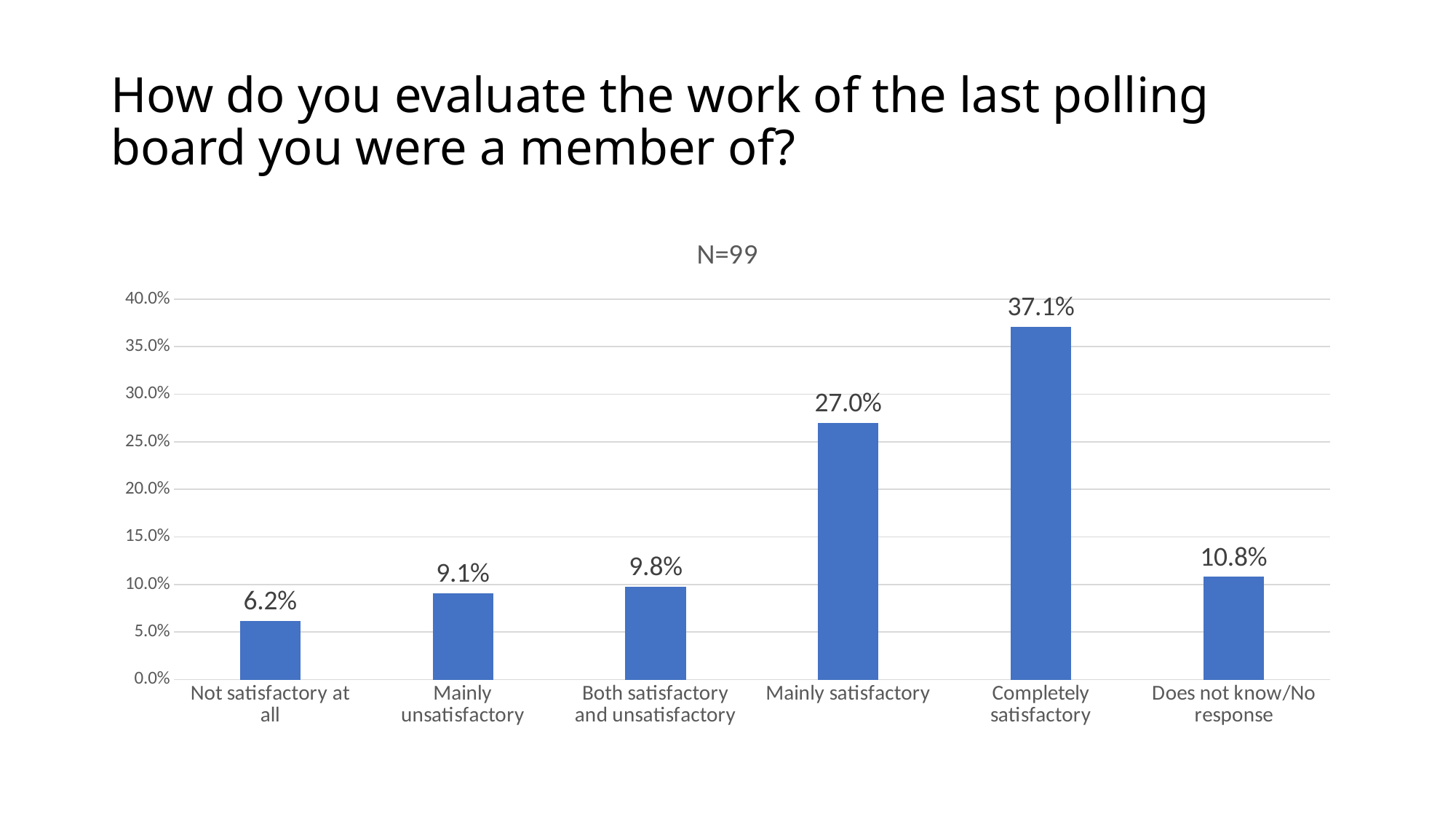
Which category has the highest value? Completely satisfactory Which category has the lowest value? Not satisfactory at all What is the chart's title? N=99 What is the value for "Mainly unsatisfactory"? 9.1% How many categories are shown on the x axis? 6 What is the difference between the values for "Completely satisfactory" and "Mainly satisfactory"? 10.1% What is the value for "Does not know/No response"? 10.8% Which is larger, the value for "Mainly satisfactory" or the value for "Both satisfactory and unsatisfactory"? Mainly satisfactory What is the difference between the values for "Does not know/No response" and "Not satisfactory at all"? 4.6% What kind of chart is shown on the slide? Bar chart What is the value for "Not satisfactory at all"? 6.2% What is the value for "Completely satisfactory"? 37.1%